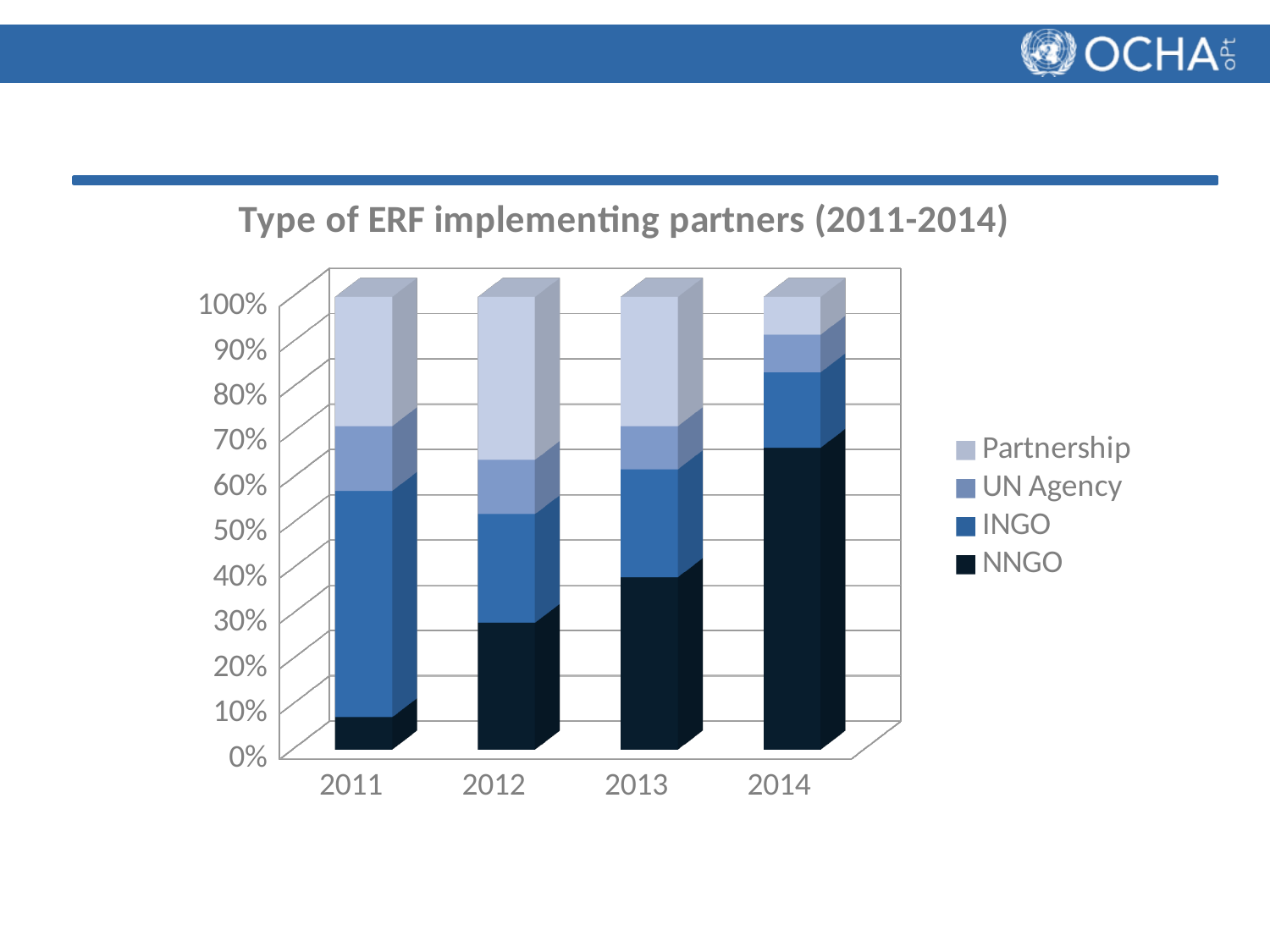
What kind of chart is shown on the slide? Stacked bar chart How many series does the legend list? 4 In which year is the NNGO share the largest? 2014 Does the NNGO share rise or fall from 2011 to 2014? rise Is the NNGO share in 2014 greater or less than 60%? greater In which year is the INGO share the largest? 2011 Is the Partnership share in 2014 greater or less than 20%? less What is the title of the chart? Type of ERF implementing partners (2011-2014) Is the NNGO share in 2011 greater or less than 20%? less How many years are shown on the x axis? 4 Which series is plotted at the bottom of each stacked bar? NNGO